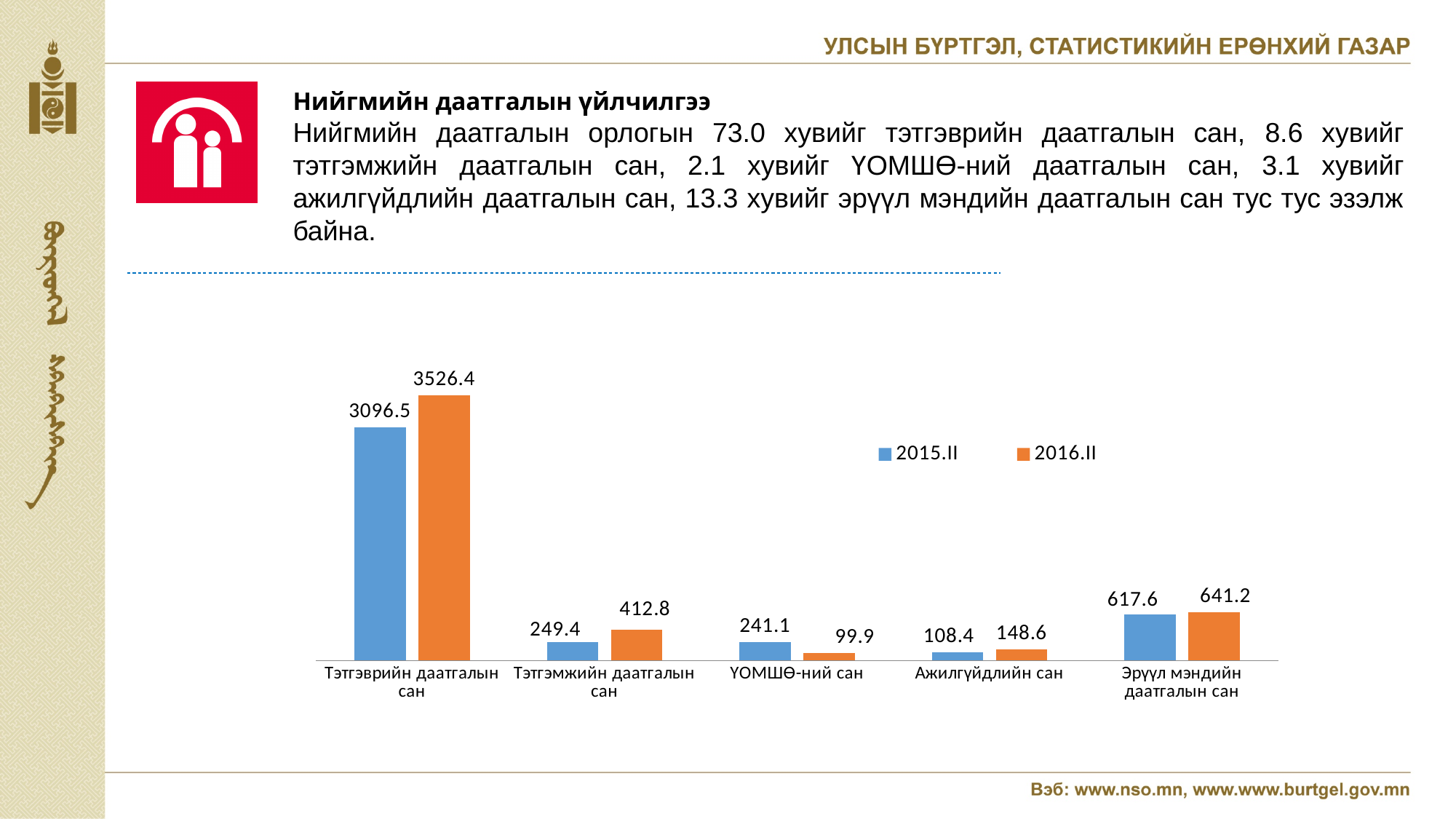
What is the value for Эрүүл мэндийн даатгалын сан in the 2015.II series? 617.6 Which colour represents the 2016.II series in the chart? Orange What is the difference between the 2016.II and 2015.II values for Тэтгэмжийн даатгалын сан? 163.4 What is the value for ҮОМШӨ-ний сан in the 2015.II series? 241.1 Which category has the highest value in the 2016.II series? Тэтгэврийн даатгалын сан Which category has the lowest value in the 2015.II series? Ажилгүйдлийн сан How many series does the legend list? 2 What kind of chart is shown on the slide? Bar chart For ҮОМШӨ-ний сан, which series has the larger value, 2015.II or 2016.II? 2015.II How many categories are shown on the x axis? 5 What is the value for Ажилгүйдлийн сан in the 2016.II series? 148.6 What is the value for Тэтгэврийн даатгалын сан in the 2016.II series? 3526.4